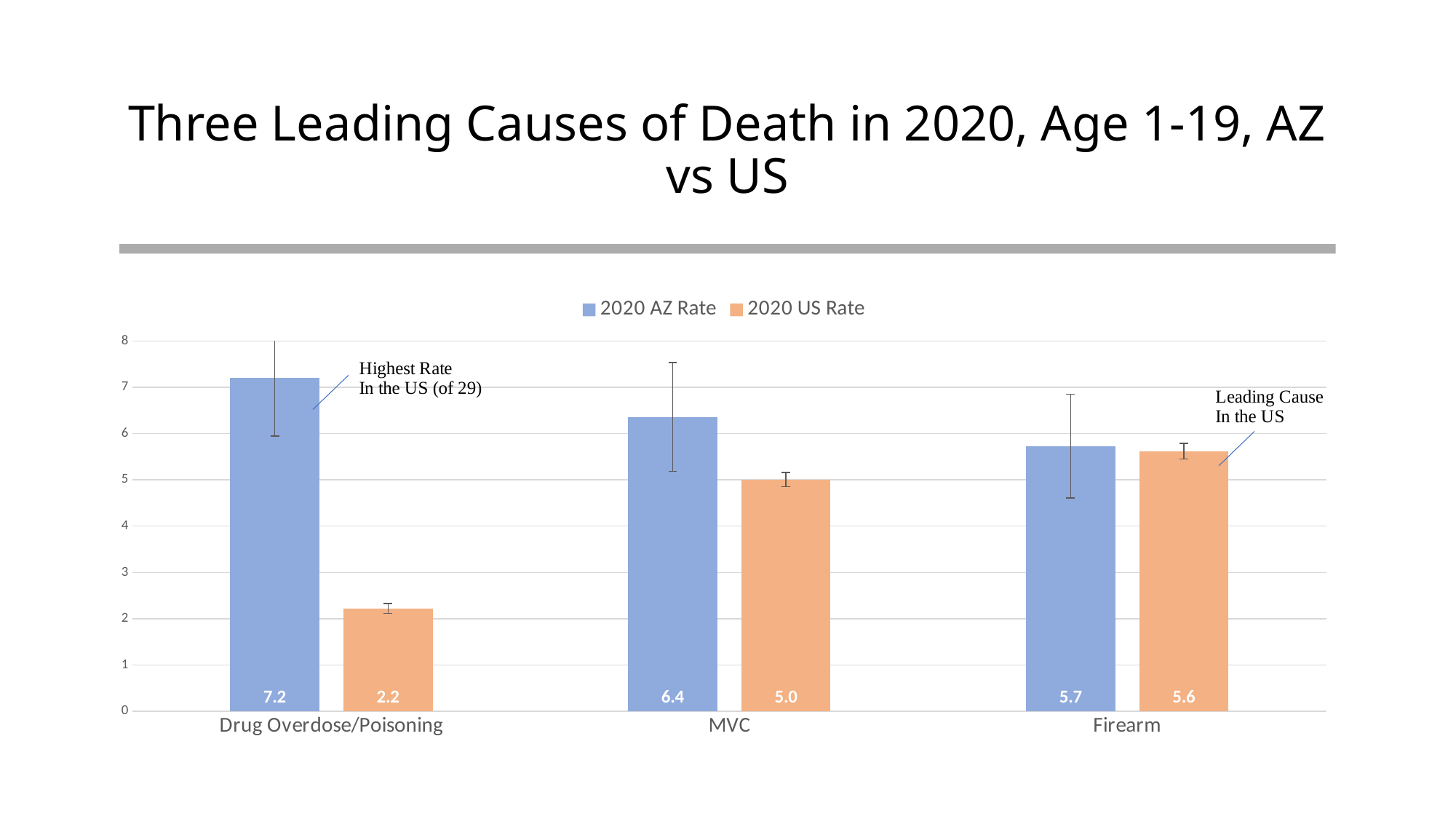
What is the 2020 AZ Rate for Drug Overdose/Poisoning? 7.2 Which is larger, the 2020 AZ Rate for MVC or the 2020 US Rate for MVC? 2020 AZ Rate for MVC Which category has the lowest 2020 US Rate? Drug Overdose/Poisoning What is the 2020 US Rate for Firearm? 5.6 Which category is annotated as the 'Leading Cause In the US'? Firearm How many series does the legend list? 2 What is the difference between the 2020 AZ Rate and the 2020 US Rate for MVC? 1.4 What kind of chart is shown on the slide? Bar chart Which category has the highest 2020 AZ Rate? Drug Overdose/Poisoning What is the 2020 US Rate for MVC? 5.0 What is the difference between the 2020 AZ Rate and the 2020 US Rate for Drug Overdose/Poisoning? 5.0 How many categories are shown on the x axis? 3